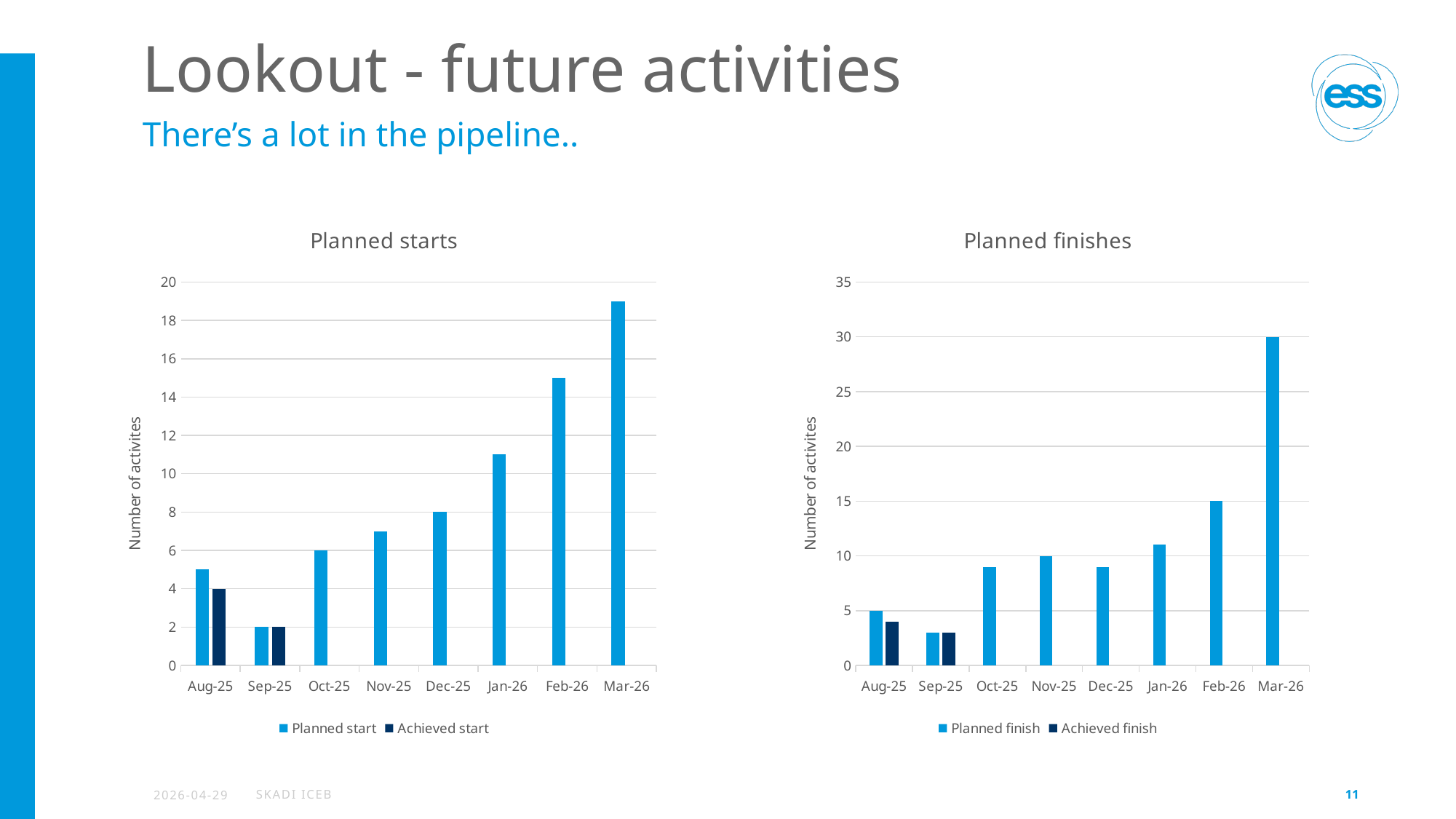
In the Planned starts chart, what is the difference between the Planned start values for Dec-25 and Oct-25? 2 In the Planned finishes chart, what is the Planned finish value for Mar-26? 30 In the Planned starts chart, which month has the highest Planned start value? Mar-26 In the Planned finishes chart, which is larger, the Planned finish for Jan-26 or for Feb-26? Feb-26 In the Planned starts chart, is the Planned start value for Mar-26 greater or less than 18? greater In the Planned finishes chart, which month has the lowest Planned finish value? Sep-25 In the Planned starts chart, what is the Planned start value for Oct-25? 6 In the Planned finishes chart, is the Planned finish value for Oct-25 greater or less than 10? less How many months are shown on the x axis of the Planned starts chart? 8 In the Planned finishes chart, what is the Planned finish value for Feb-26? 15 In the Planned starts chart, what is the Achieved start value for Aug-25? 4 How many series does the legend of the Planned finishes chart list? 2